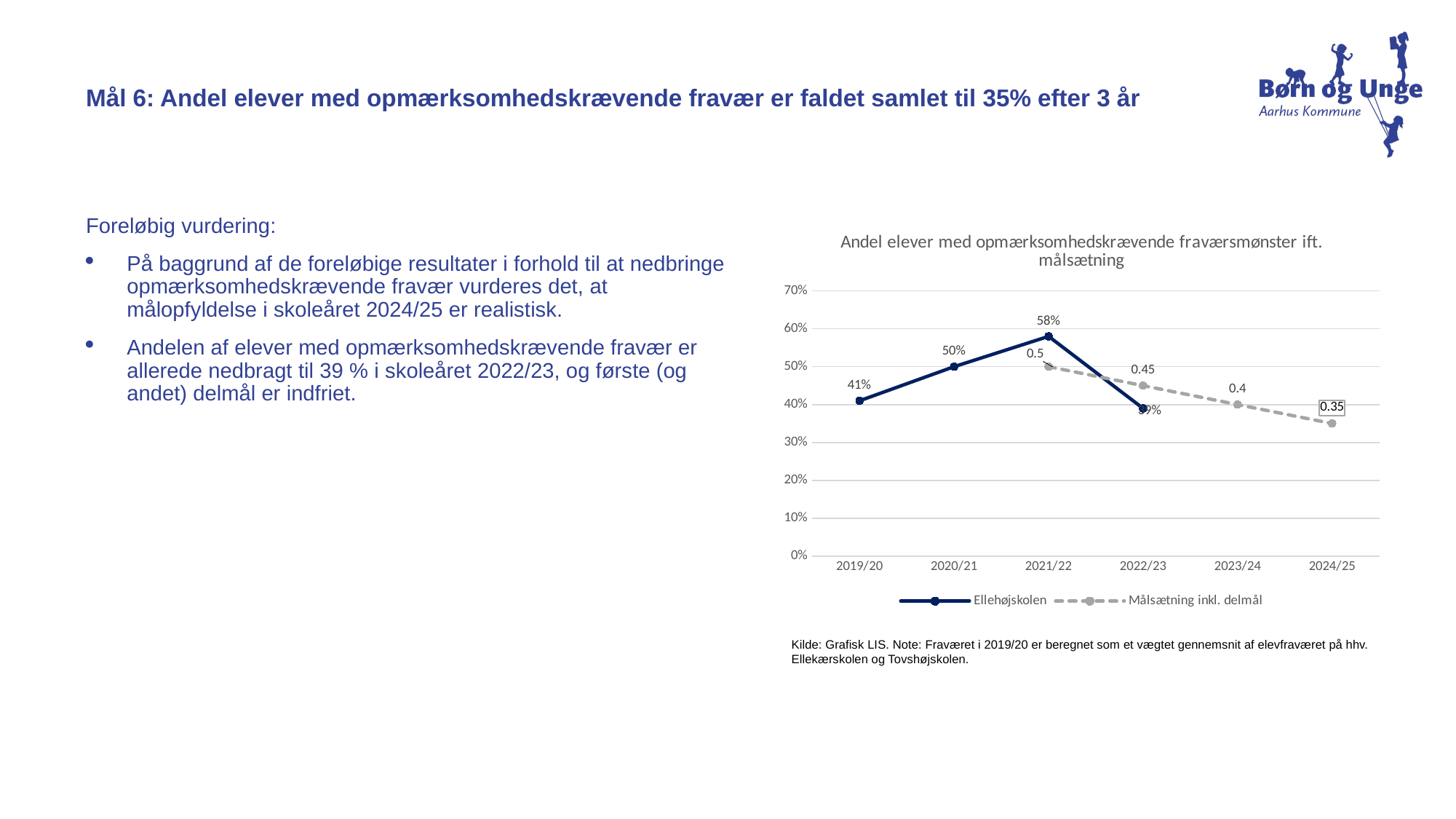
What is the value for Ellehøjskolen in 2021/22? 58% Does the Målsætning inkl. delmål series rise or fall from 2021/22 to 2024/25? fall What is the value for Ellehøjskolen in 2020/21? 50% What is the value for Ellehøjskolen in 2019/20? 41% What type of chart is shown on the slide? line chart Which is larger: the Ellehøjskolen value in 2020/21 or in 2019/20? 2020/21 What is the value of the Målsætning inkl. delmål series in 2024/25? 0.35 In which school year does the Ellehøjskolen series reach its highest value? 2021/22 What is the value of the Målsætning inkl. delmål series in 2022/23? 0.45 What is the difference between the Ellehøjskolen values for 2021/22 and 2019/20? 17% How many series does the legend list? 2